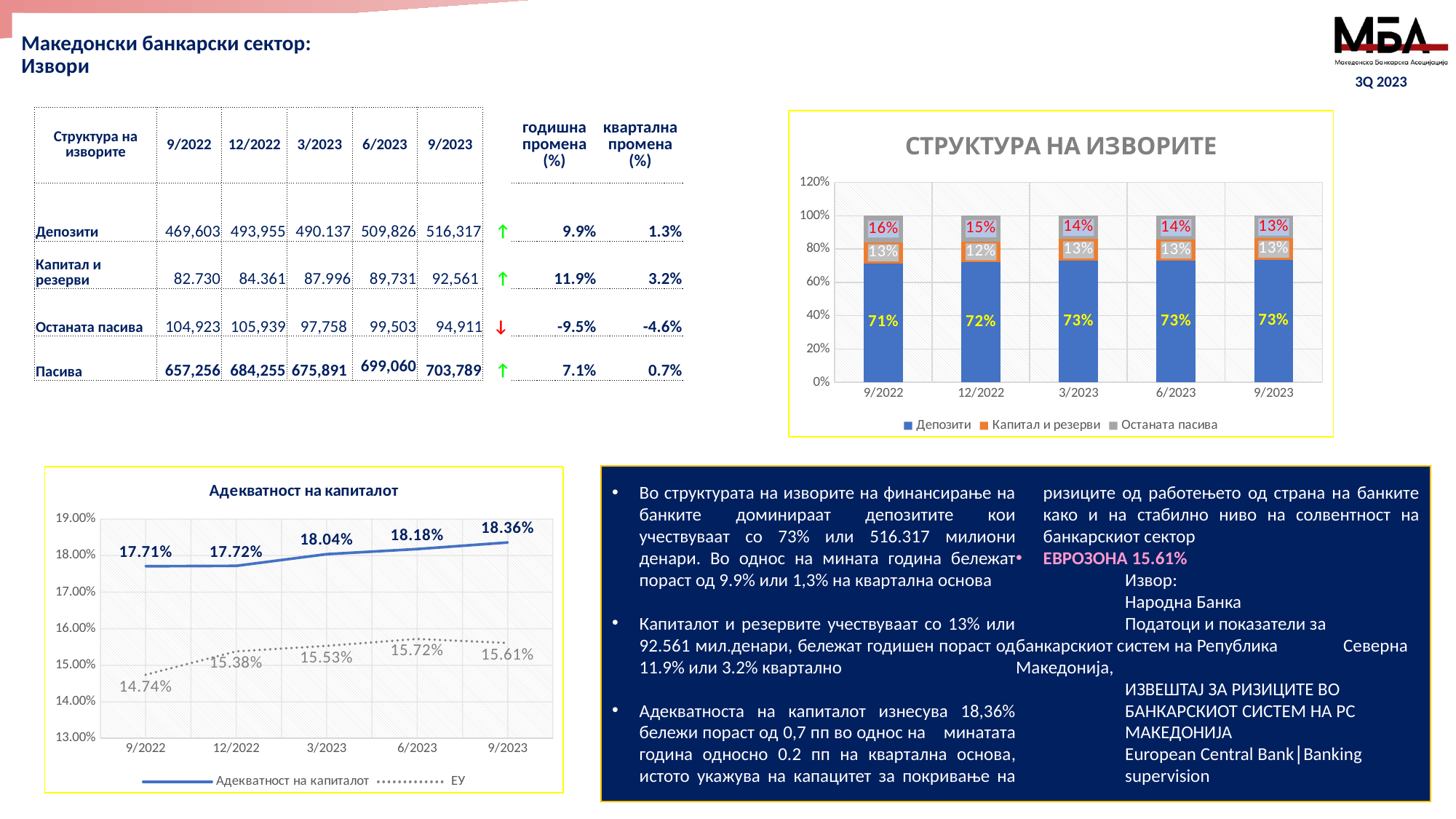
In the 'Адекватност на капиталот' chart, which period has the highest value for ЕУ? 6/2023 In the 'Адекватност на капиталот' chart, what is the difference between Адекватност на капиталот and ЕУ in 9/2023? 2.75% In the 'СТРУКТУРА НА ИЗВОРИТЕ' chart, what is the value for Капитал и резерви in 12/2022? 12% In the 'СТРУКТУРА НА ИЗВОРИТЕ' chart, what is the total of the stacked bar for 3/2023? 100% In the 'СТРУКТУРА НА ИЗВОРИТЕ' chart, what is the value for Останата пасива in 9/2022? 16% In the 'Адекватност на капиталот' chart, what is the value of Адекватност на капиталот in 9/2023? 18.36% In the 'СТРУКТУРА НА ИЗВОРИТЕ' chart, what is the value for Депозити in 9/2023? 73% In the 'Адекватност на капиталот' chart, how many periods are shown on the x axis? 5 In the 'СТРУКТУРА НА ИЗВОРИТЕ' chart, how many series does the legend list? 3 In the 'Адекватност на капиталот' chart, what is the value of ЕУ in 9/2022? 14.74% In the 'СТРУКТУРА НА ИЗВОРИТЕ' chart, does the share of Останата пасива rise or fall from 9/2022 to 9/2023? Fall In the 'СТРУКТУРА НА ИЗВОРИТЕ' chart, what kind of chart is shown? Stacked bar chart